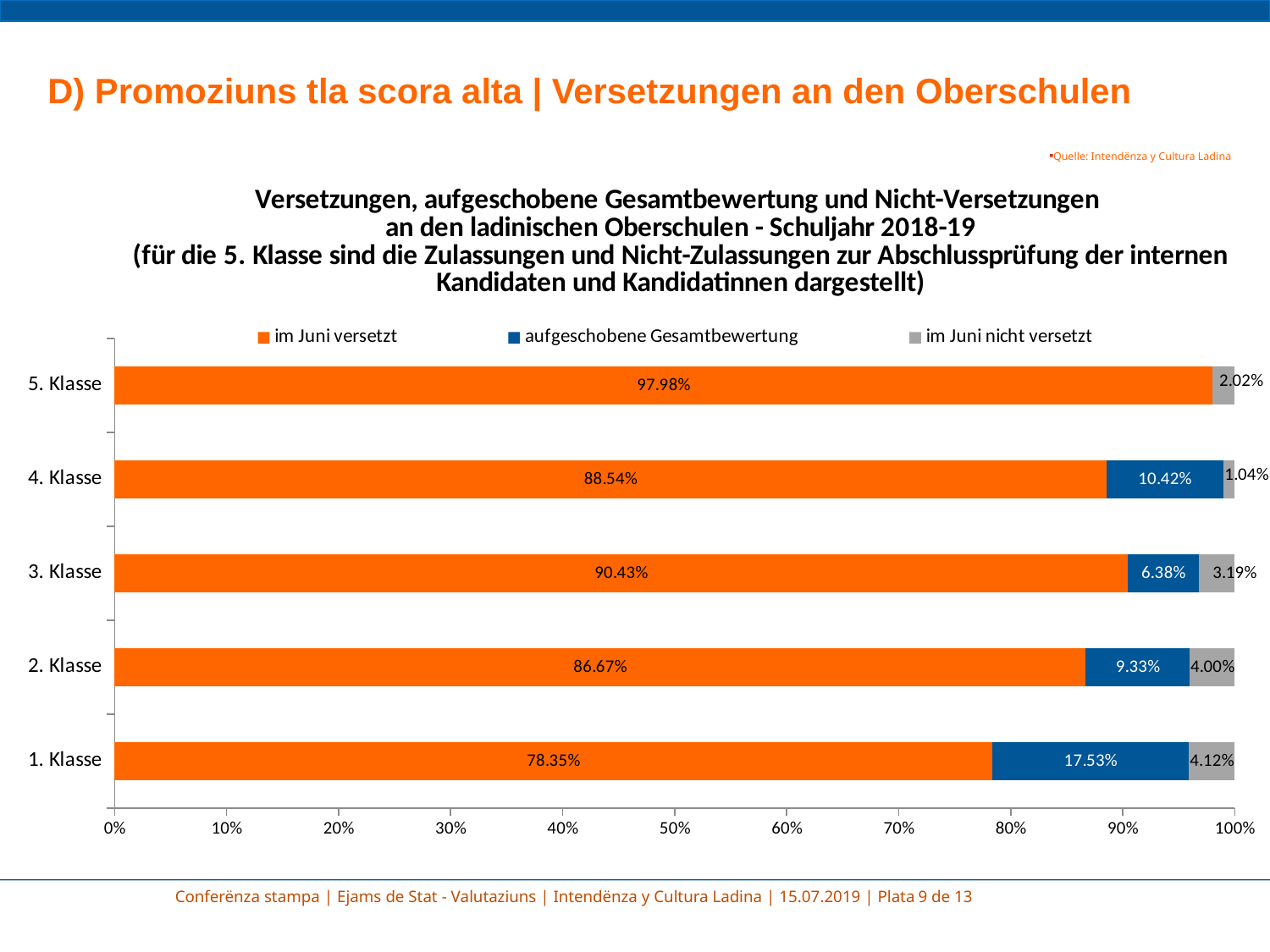
What is the value of 'aufgeschobene Gesamtbewertung' for 4. Klasse? 10.42% Which series is shown in orange in the legend? im Juni versetzt What is the value of 'im Juni nicht versetzt' for 3. Klasse? 3.19% Which class has the highest share of 'im Juni versetzt'? 5. Klasse Which is larger, the 'im Juni nicht versetzt' value for 1. Klasse or for 2. Klasse? 1. Klasse Which class has the lowest share of 'im Juni versetzt'? 1. Klasse How many series does the legend list? 3 What kind of chart is shown on the slide? Stacked bar chart How many classes are shown on the chart? 5 What is the difference between the 'aufgeschobene Gesamtbewertung' values for 1. Klasse and 2. Klasse? 8.20% Which class has the highest share of 'aufgeschobene Gesamtbewertung'? 1. Klasse What is the value of 'im Juni versetzt' for 1. Klasse? 78.35%